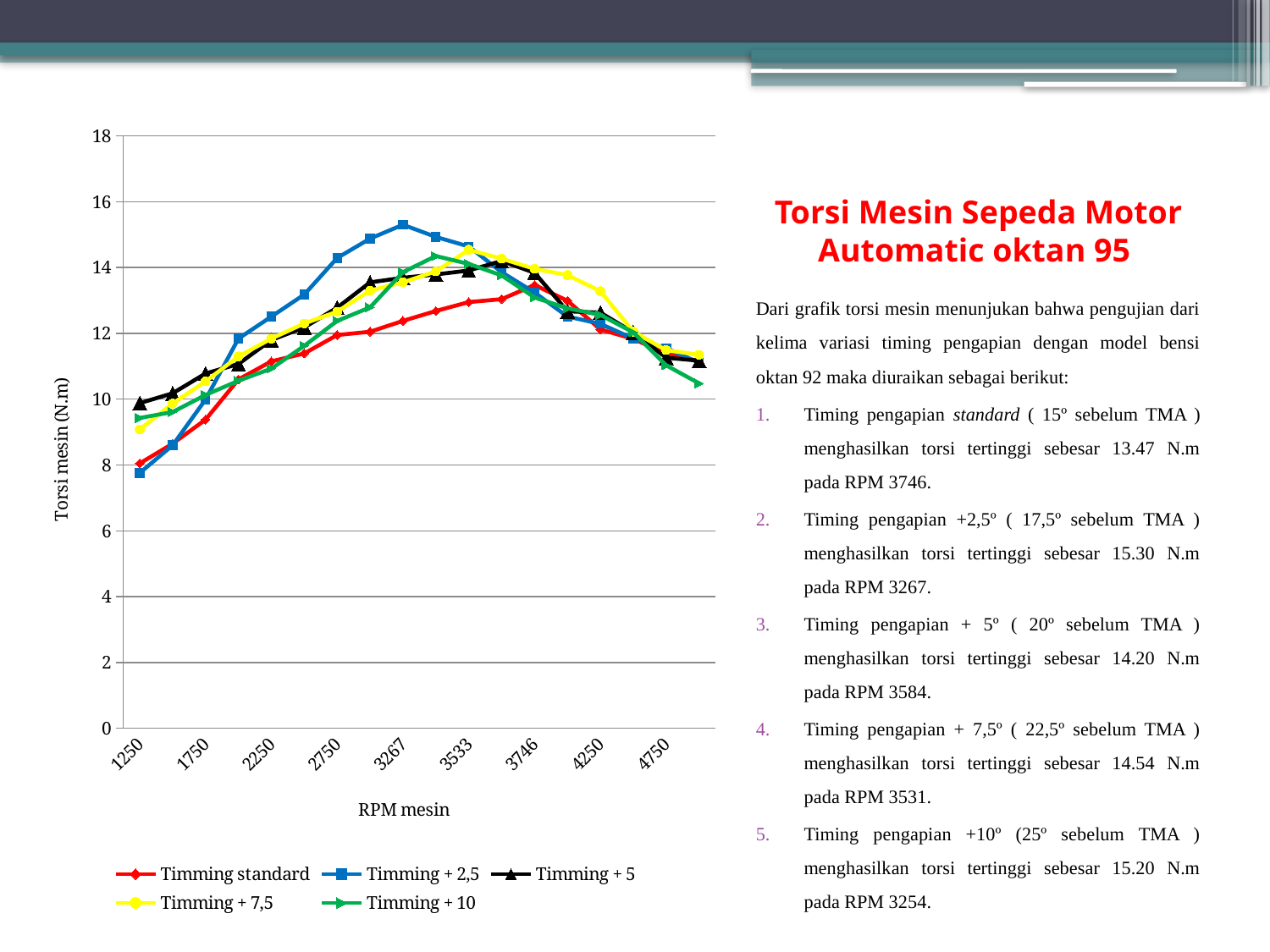
What kind of chart is shown on the slide? line chart How many series does the chart legend list? 5 Is the value for Timming standard at 3267 RPM greater or less than 14? less Is the value for Timming + 2,5 at 1250 RPM greater or less than 10? less At 3267 RPM, which series has the larger value: Timming + 2,5 or Timming standard? Timming + 2,5 What is the title of the vertical axis of the chart? Torsi mesin (N.m) Which series reaches the highest torque value anywhere on the chart? Timming + 2,5 Does the Timming + 2,5 series rise or fall from 3267 RPM to 4750 RPM? fall Is the value for Timming + 10 at 4750 RPM greater or less than 12? less At 1250 RPM, which series has the larger value: Timming + 5 or Timming + 2,5? Timming + 5 What is the title of the horizontal axis of the chart? RPM mesin